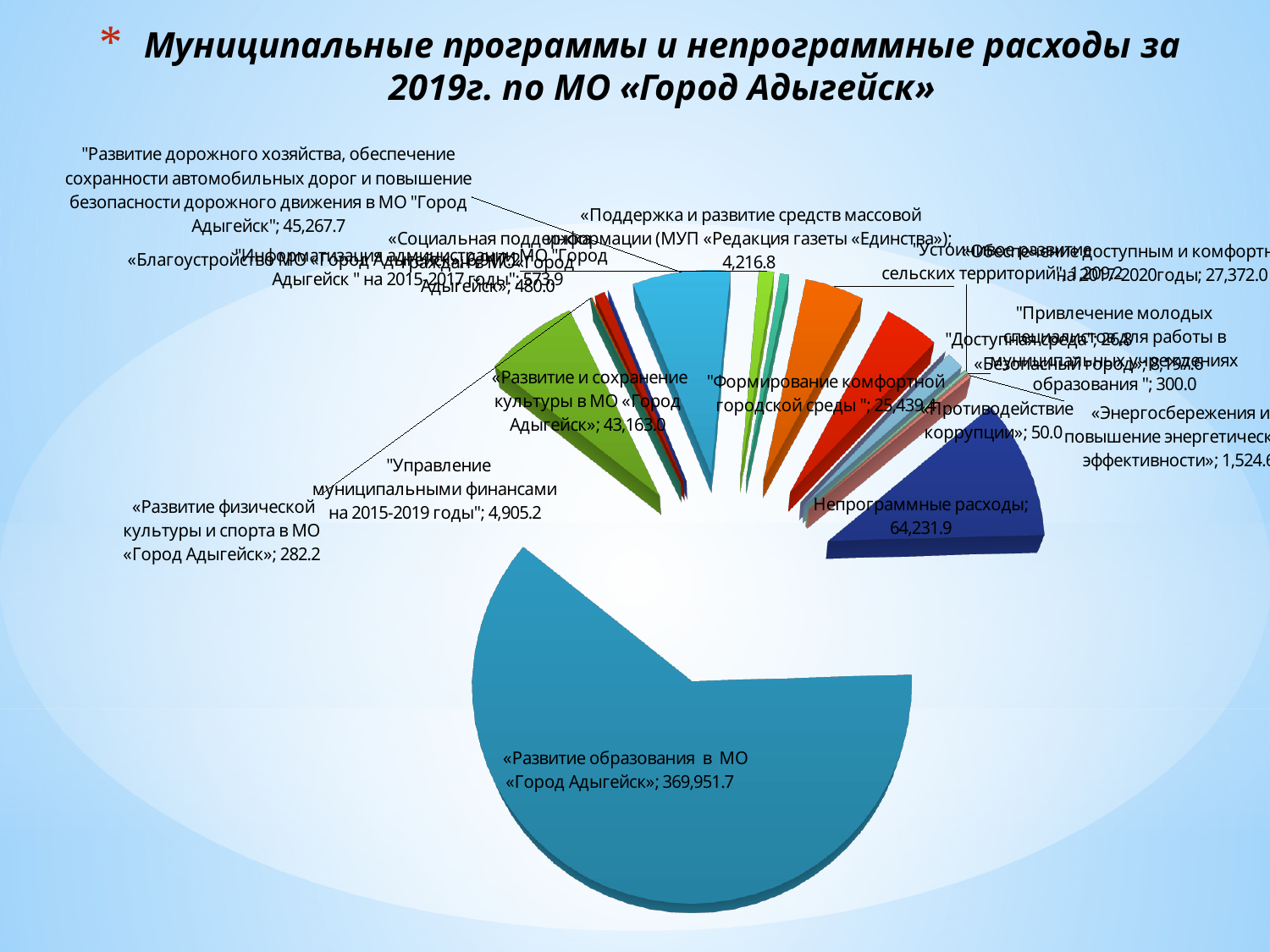
What is the value for «Противодействие коррупции»? 50.0 What kind of chart is shown on the slide? pie chart What is the title of the slide containing the chart? Муниципальные программы и непрограммные расходы за 2019г. по МО «Город Адыгейск» What is the value for «Развитие образования в МО «Город Адыгейск»? 369,951.7 What is the value for "Управление муниципальными финансами на 2015-2019 годы"? 4,905.2 What is the value for «Развитие физической культуры и спорта в МО «Город Адыгейск»? 282.2 Which category has the largest slice of the pie? «Развитие образования в МО «Город Адыгейск» What is the difference between the value for Непрограммные расходы and the value for "Развитие дорожного хозяйства, обеспечение сохранности автомобильных дорог и повышение безопасности дорожного движения в МО "Город Адыгейск"? 18,964.2 What is the value for «Поддержка и развитие средств массовой информации (МУП «Редакция газеты «Единства»)? 4,216.8 What is the value for Непрограммные расходы? 64,231.9 What is the value for «Развитие и сохранение культуры в МО «Город Адыгейск»? 43,163.0 Which is larger: Непрограммные расходы or "Развитие дорожного хозяйства, обеспечение сохранности автомобильных дорог и повышение безопасности дорожного движения в МО "Город Адыгейск"? Непрограммные расходы